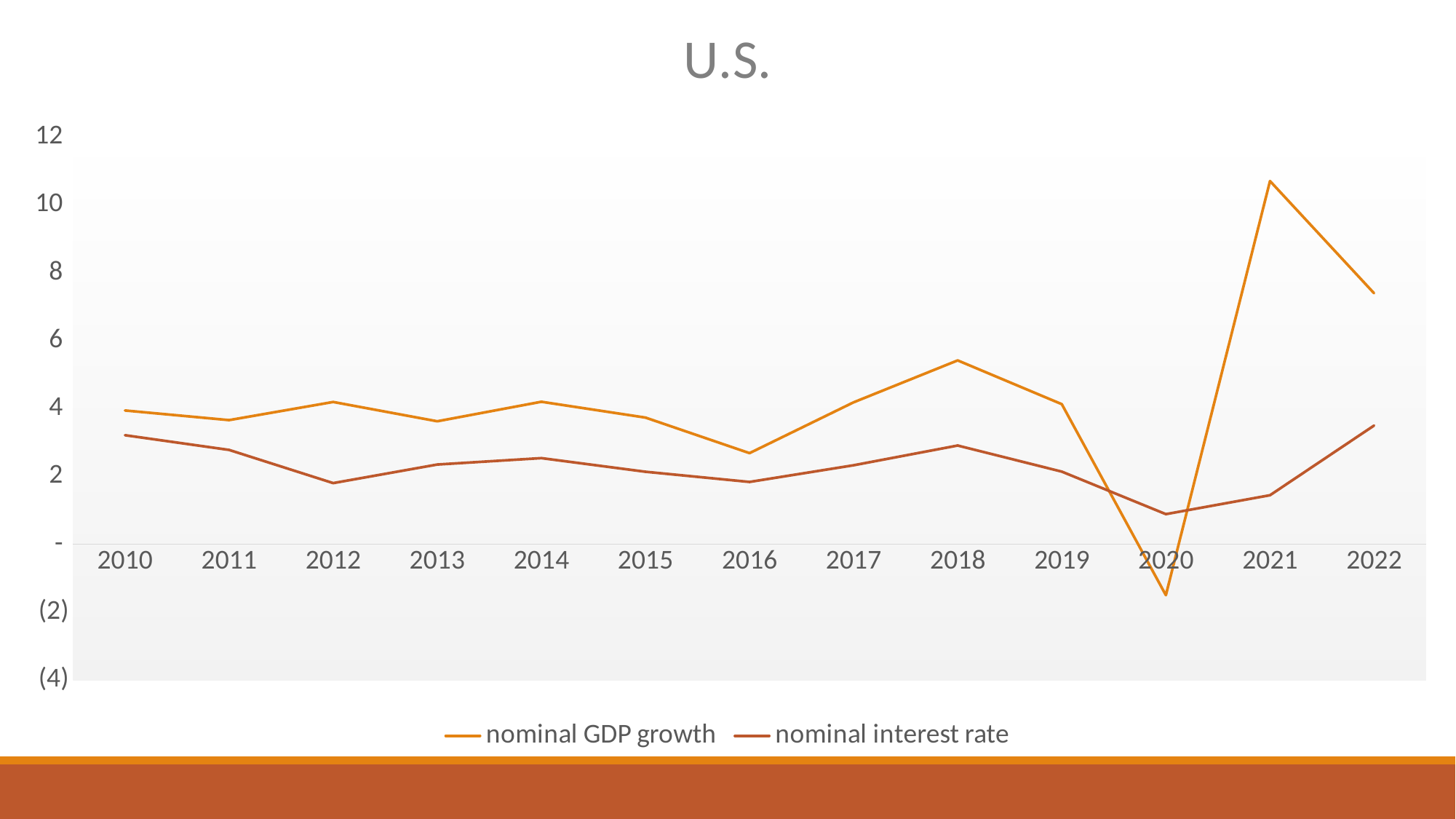
Is the value for nominal GDP growth in 2022 greater or less than 6? greater Is the value for the nominal interest rate in 2020 greater or less than 2? less What kind of chart is shown on the slide? line chart In which year is nominal GDP growth highest? 2021 In 2020, which is larger: nominal GDP growth or the nominal interest rate? nominal interest rate How many years are plotted along the x axis? 13 In which year is the nominal interest rate lowest? 2020 In which year is nominal GDP growth lowest? 2020 Does nominal GDP growth rise or fall from 2021 to 2022? fall Is the value for nominal GDP growth in 2021 greater or less than 10? greater How many series does the legend list? 2 In 2018, which is larger: nominal GDP growth or the nominal interest rate? nominal GDP growth